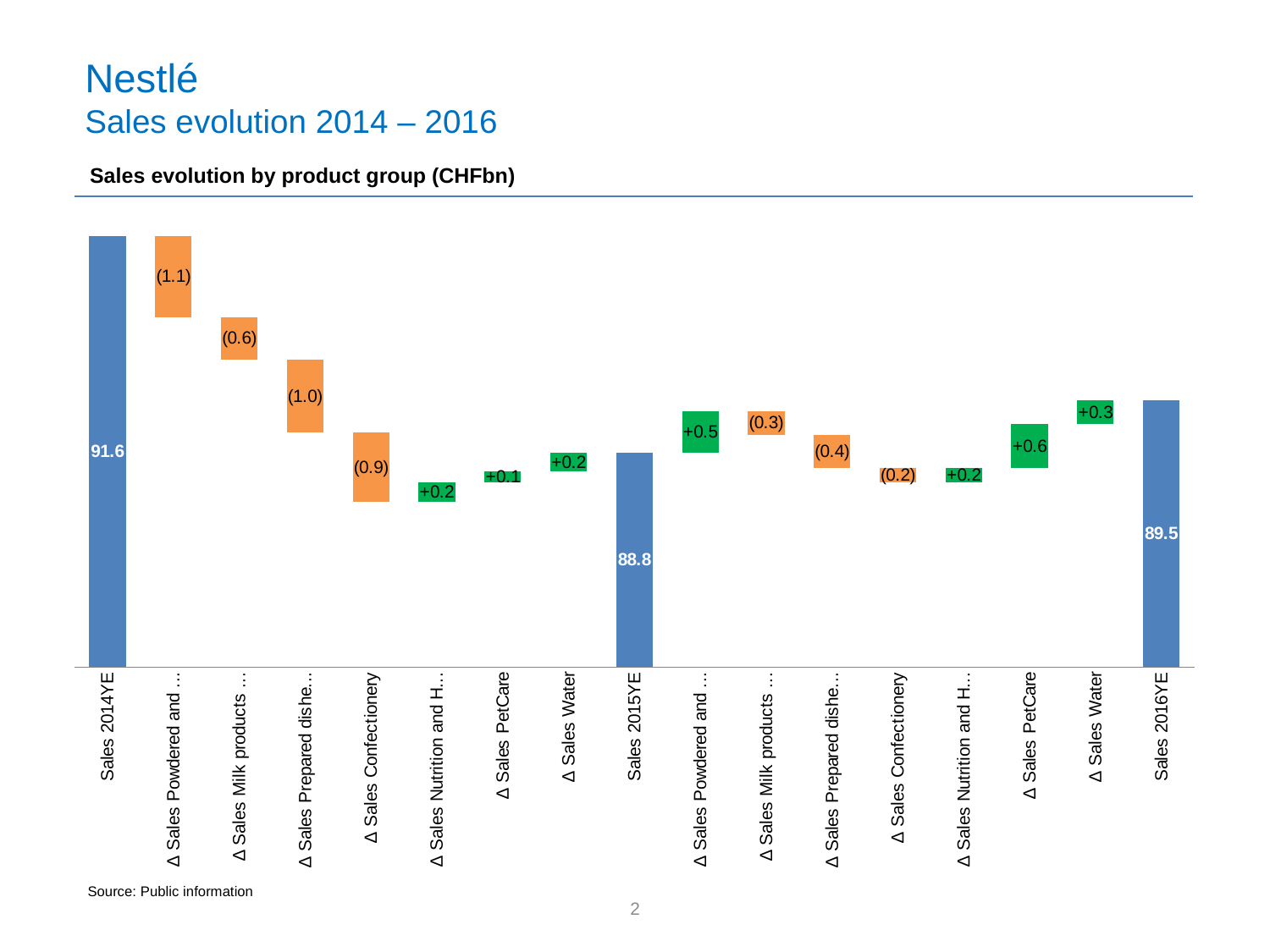
Which of the three year-end sales bars has the highest value? Sales 2014YE What is the difference between the Sales 2014YE and Sales 2015YE values? 2.8 What is the value of the Sales 2015YE bar? 88.8 What is the Δ Sales Confectionery value between Sales 2014YE and Sales 2015YE? (0.9) What is the value of the Sales 2014YE bar? 91.6 How many bars are plotted on the chart? 17 What is the Δ Sales Water value between Sales 2014YE and Sales 2015YE? +0.2 What is the Δ Sales PetCare value between Sales 2015YE and Sales 2016YE? +0.6 What kind of chart is shown on the slide? Bar chart (waterfall) What is the value of the Sales 2016YE bar? 89.5 Which is larger, the Sales 2015YE value or the Sales 2016YE value? Sales 2016YE What is the title of the chart? Sales evolution by product group (CHFbn)